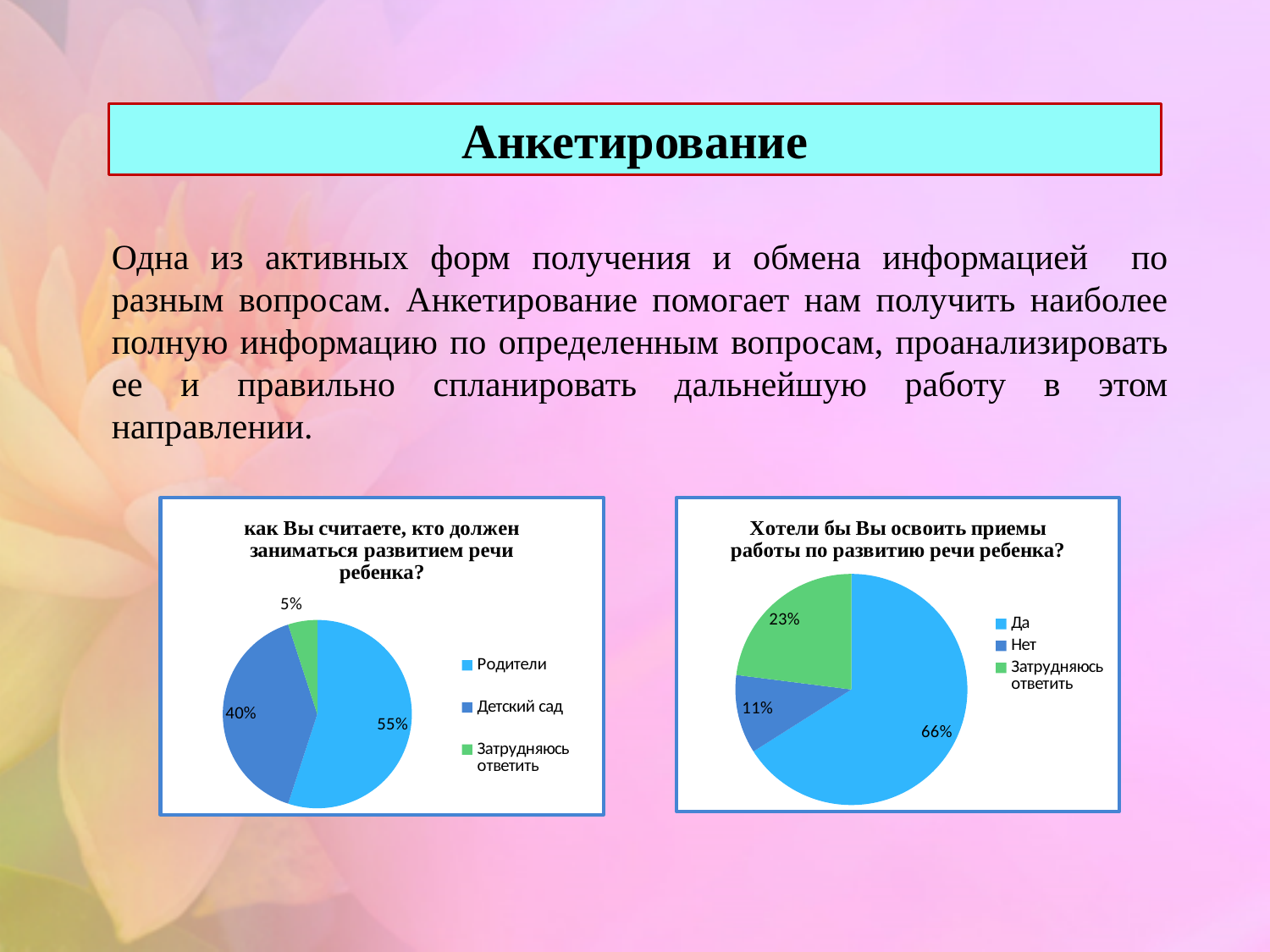
In the right chart ("Хотели бы Вы освоить приемы работы по развитию речи ребенка?"), what colour is the Да slice? Light blue In the right chart ("Хотели бы Вы освоить приемы работы по развитию речи ребенка?"), what share is labelled for Затрудняюсь ответить? 23% In the left chart ("как Вы считаете, кто должен заниматься развитием речи ребенка?"), how many categories does the legend list? 3 In the right chart ("Хотели бы Вы освоить приемы работы по развитию речи ребенка?"), which is larger: Нет or Затрудняюсь ответить? Затрудняюсь ответить In the right chart ("Хотели бы Вы освоить приемы работы по развитию речи ребенка?"), which category has the largest slice? Да In the right chart ("Хотели бы Вы освоить приемы работы по развитию речи ребенка?"), what share is labelled for Да? 66% In the right chart ("Хотели бы Вы освоить приемы работы по развитию речи ребенка?"), what share is labelled for Нет? 11% In the left chart ("как Вы считаете, кто должен заниматься развитием речи ребенка?"), what share is labelled for Детский сад? 40% In the left chart ("как Вы считаете, кто должен заниматься развитием речи ребенка?"), what share is labelled for Родители? 55% In the left chart ("как Вы считаете, кто должен заниматься развитием речи ребенка?"), which category has the smallest slice? Затрудняюсь ответить In the left chart ("как Вы считаете, кто должен заниматься развитием речи ребенка?"), what is the difference between the Родители and Детский сад shares? 15% What type of chart is the right chart ("Хотели бы Вы освоить приемы работы по развитию речи ребенка?")? Pie chart